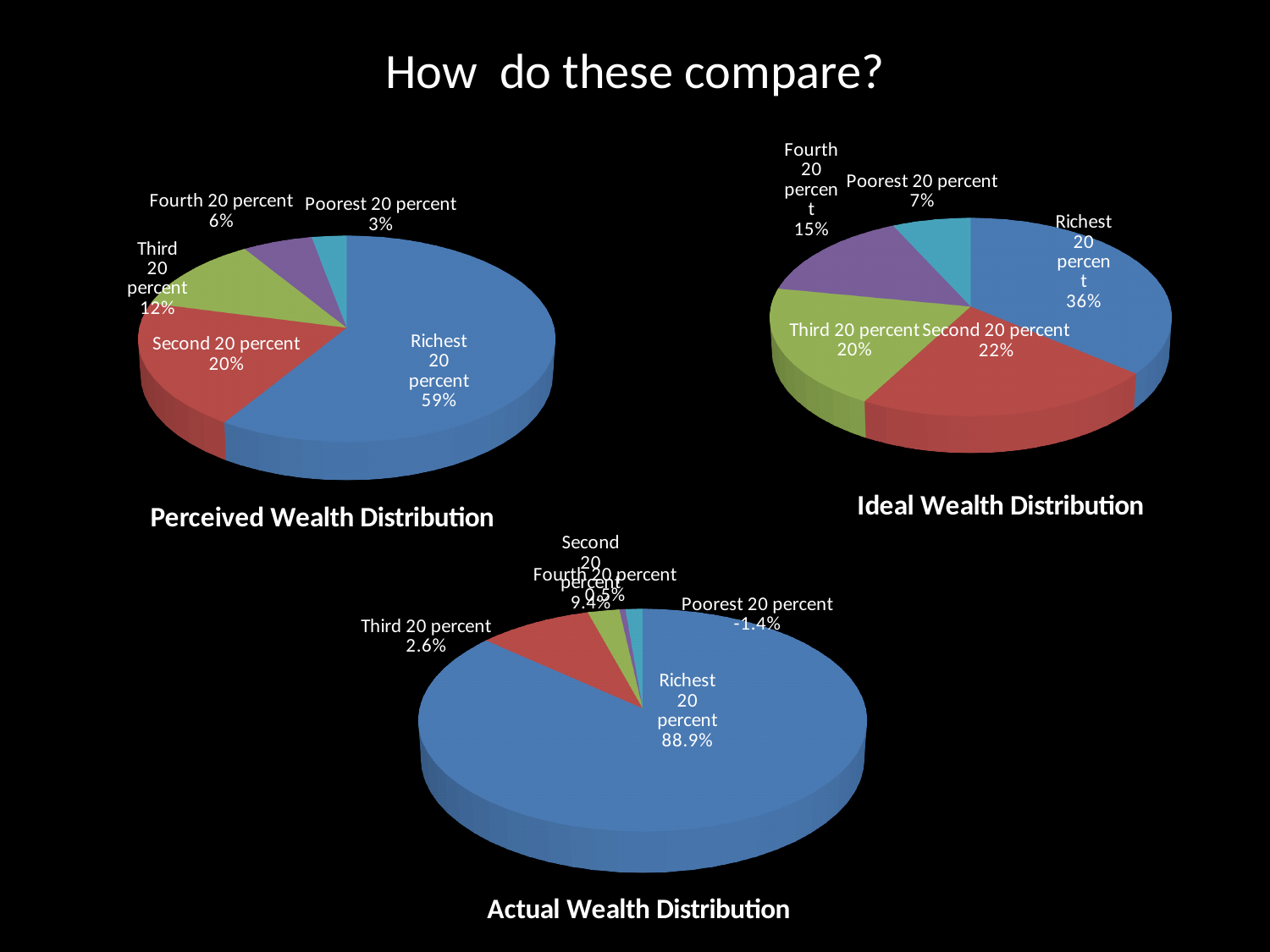
In the Perceived Wealth Distribution chart, what is the difference between the Second 20 percent and the Fourth 20 percent shares? 14% In the Ideal Wealth Distribution chart, which is larger, the Second 20 percent or the Poorest 20 percent? Second 20 percent How many slices does the Perceived Wealth Distribution chart have? 5 In the Actual Wealth Distribution chart, what share is labelled for the Poorest 20 percent? -1.4% In the Perceived Wealth Distribution chart, what share is labelled for the Richest 20 percent? 59% In the Ideal Wealth Distribution chart, which category has the largest slice? Richest 20 percent In the Ideal Wealth Distribution chart, what share is labelled for the Fourth 20 percent? 15% In the Actual Wealth Distribution chart, what share is labelled for the Richest 20 percent? 88.9% In the Perceived Wealth Distribution chart, which category has the smallest slice? Poorest 20 percent In the Perceived Wealth Distribution chart, what share is labelled for the Third 20 percent? 12% What type of chart is the Actual Wealth Distribution chart? Pie chart In the Ideal Wealth Distribution chart, what share is labelled for the Richest 20 percent? 36%